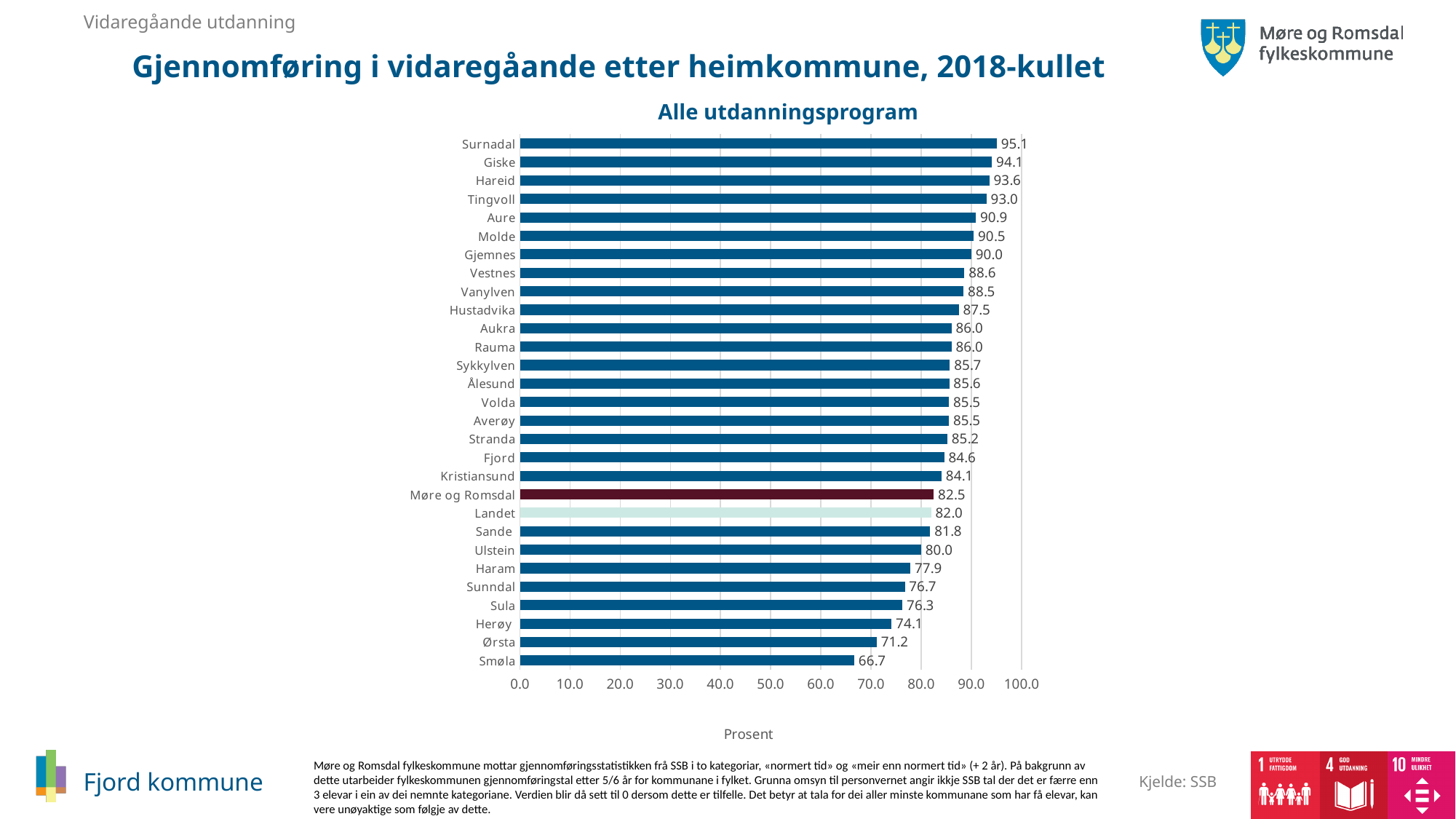
What is the difference between the values for Fjord and Landet? 2.6 What kind of chart is shown on the slide? Bar chart What is the value for Landet? 82.0 How many categories are shown in the chart? 29 Which category has the lowest value? Smøla What is the difference between the values for Surnadal and Smøla? 28.4 Which is larger, the value for Molde or the value for Ålesund? Molde What is the value for Møre og Romsdal? 82.5 Is the value for Ørsta greater or less than 80.0? less What is the title of the chart? Alle utdanningsprogram Which category has the highest value? Surnadal What is the value for Fjord? 84.6